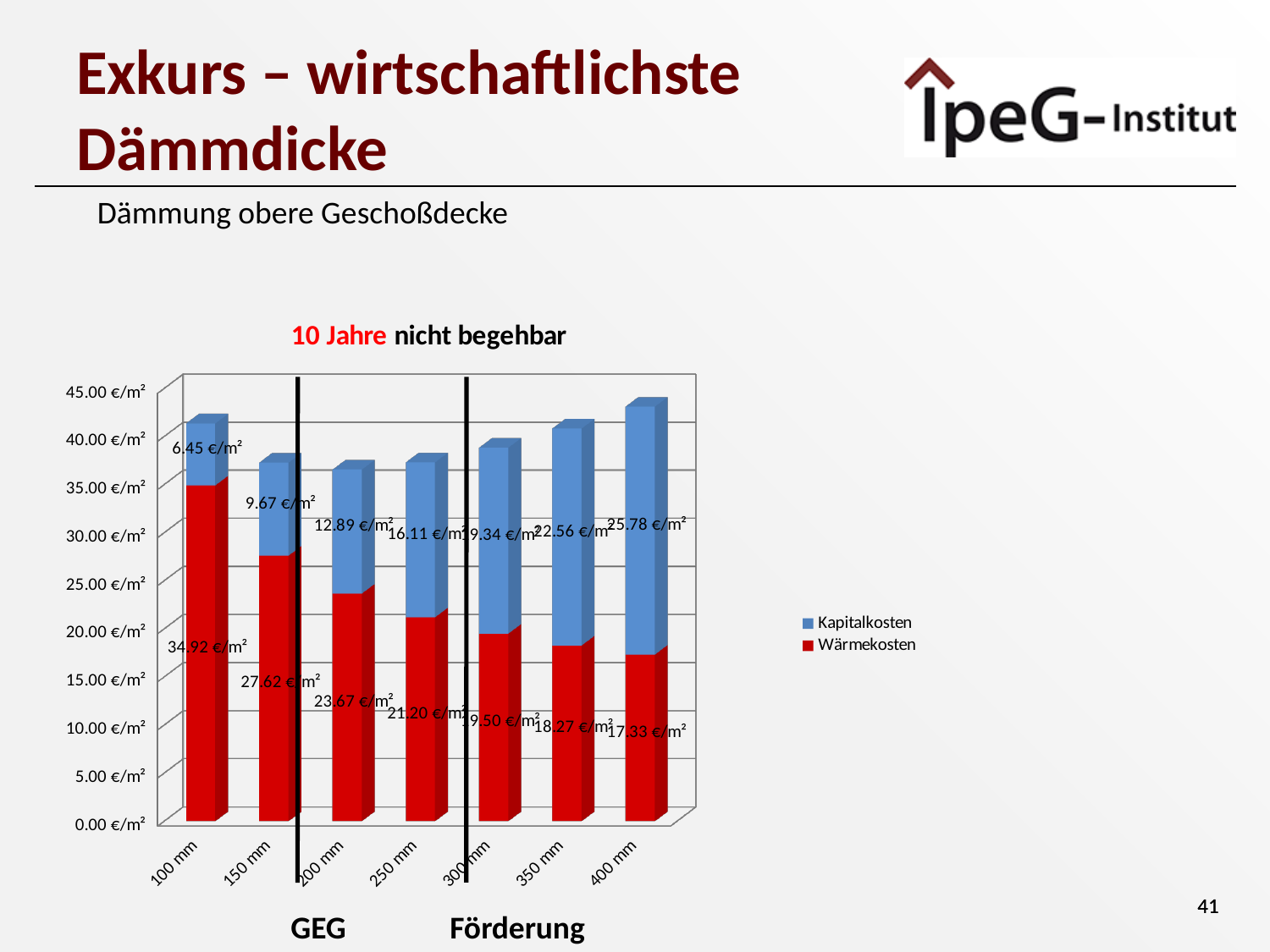
What is the Kapitalkosten value for 400 mm? 25.78 €/m² How many series does the legend list? 2 What is the Kapitalkosten value for 250 mm? 16.11 €/m² Which category has the lowest Kapitalkosten value? 100 mm How many categories are shown on the x axis? 7 What is the difference between the Wärmekosten values for 150 mm and 200 mm? 3.95 €/m² Which category has the highest Wärmekosten value? 100 mm Do the Kapitalkosten values rise or fall as the insulation thickness increases from 100 mm to 400 mm? Rise What is the Wärmekosten value for 100 mm? 34.92 €/m² Which is larger for 300 mm: Kapitalkosten or Wärmekosten? Wärmekosten What is the total of the stacked bar for 200 mm? 36.56 €/m² What kind of chart is shown? Stacked bar chart